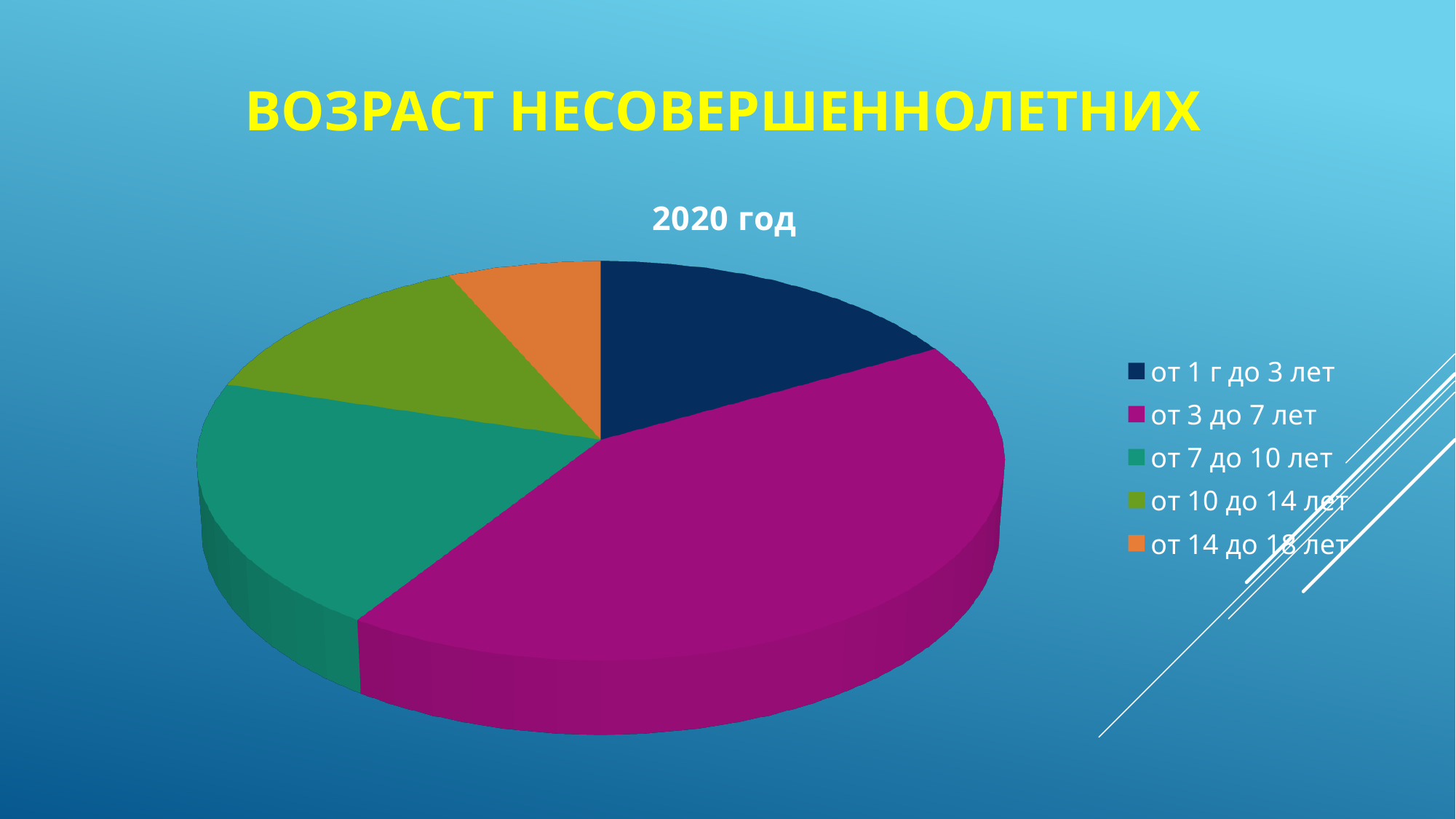
What kind of chart is shown on the slide? pie chart Which slice is larger: от 7 до 10 лет or от 14 до 18 лет? от 7 до 10 лет Which slice is larger: от 3 до 7 лет or от 1 г до 3 лет? от 3 до 7 лет What is the title of the chart? 2020 год Which age group has the largest slice of the pie? от 3 до 7 лет How many categories does the pie chart show? 5 Which slice is larger: от 3 до 7 лет or от 7 до 10 лет? от 3 до 7 лет Which age group has the smallest slice of the pie? от 14 до 18 лет Which age group is shown in orange in the legend? от 14 до 18 лет